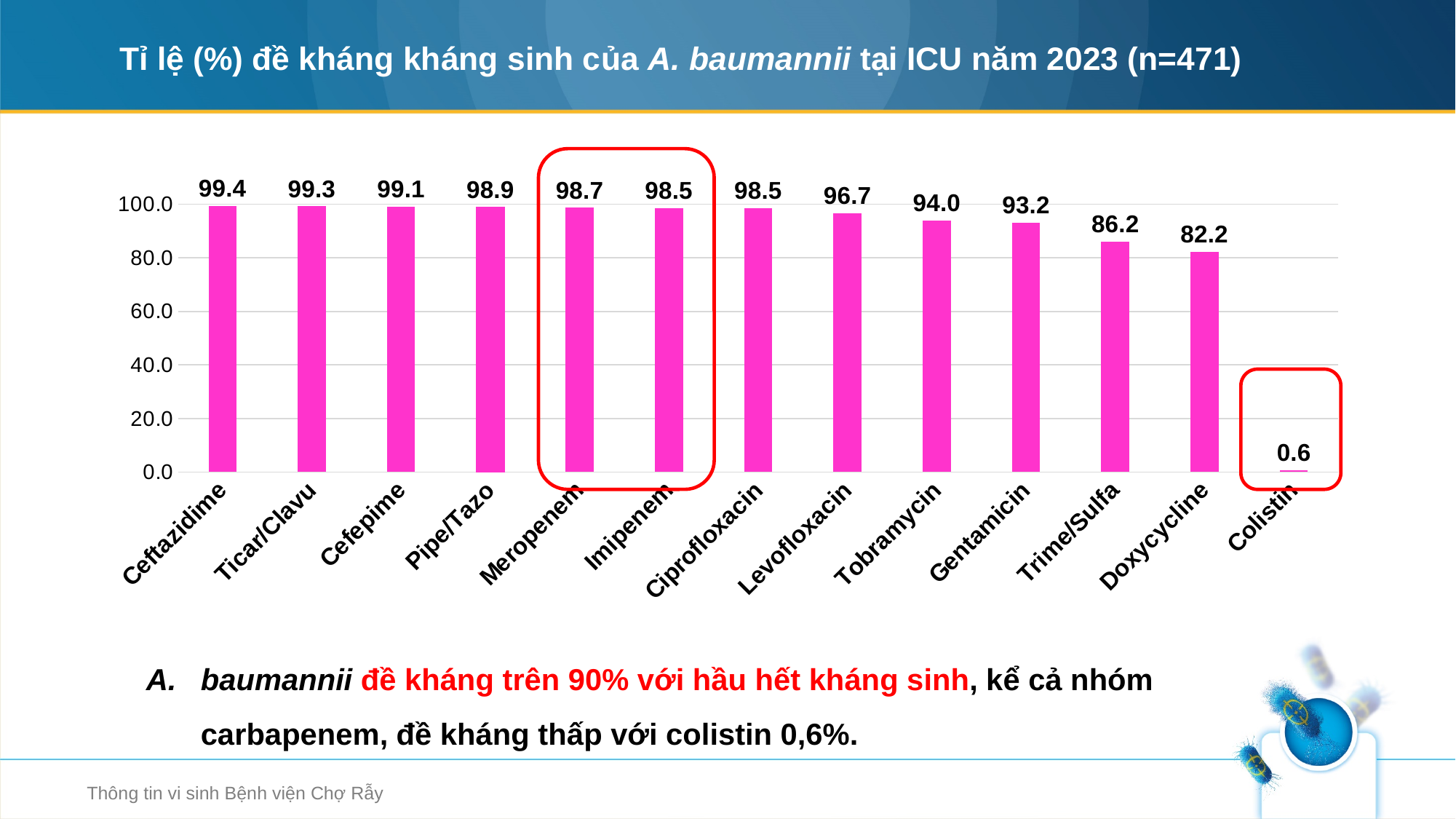
Is the value for Tobramycin greater or less than 80.0? greater Which antibiotic has the lowest resistance rate? Colistin What kind of chart is shown on the slide? Bar chart What colour are the bars in the chart? Pink (magenta) How many antibiotics are shown on the x axis? 13 What is the resistance rate for Ceftazidime? 99.4 Which has a higher resistance rate, Levofloxacin or Gentamicin? Levofloxacin What is the resistance rate for Doxycycline? 82.2 What is the resistance rate for Colistin? 0.6 What is the resistance rate for Meropenem? 98.7 What is the difference between the resistance rates for Trime/Sulfa and Doxycycline? 4.0 Which antibiotic has the highest resistance rate? Ceftazidime